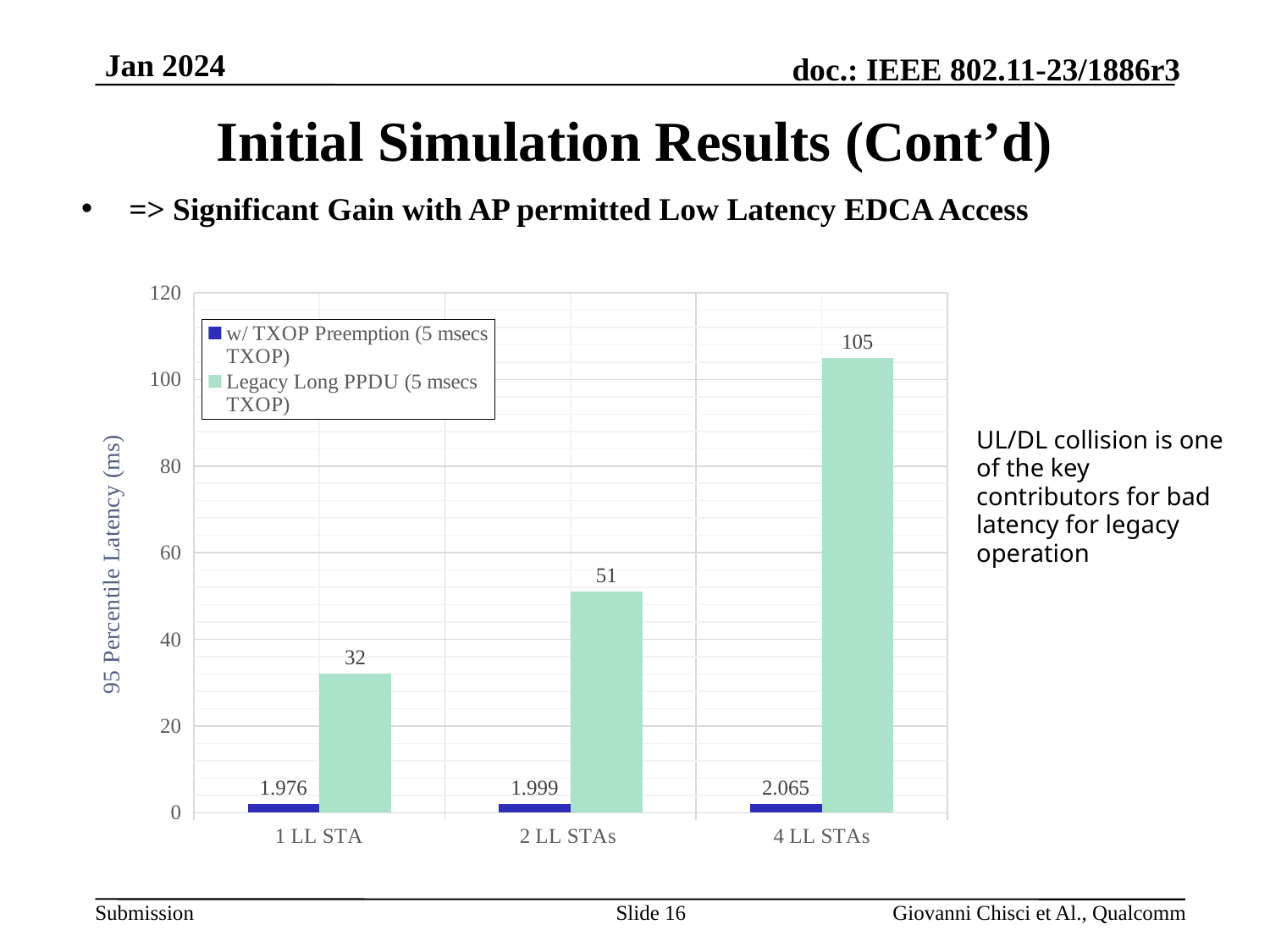
How many categories are shown on the x axis? 3 What is the difference between the Legacy Long PPDU values for 4 LL STAs and 2 LL STAs? 54 What is the value for Legacy Long PPDU (5 msecs TXOP) with 2 LL STAs? 51 Which category has the lowest w/ TXOP Preemption (5 msecs TXOP) latency? 1 LL STA What is the 95 percentile latency for w/ TXOP Preemption (5 msecs TXOP) with 1 LL STA? 1.976 Which is larger for 1 LL STA: the w/ TXOP Preemption value or the Legacy Long PPDU value? Legacy Long PPDU (5 msecs TXOP) Is the Legacy Long PPDU value for 4 LL STAs greater or less than 100? greater How many series does the legend list? 2 What kind of chart is shown on the slide? bar chart Which category has the highest Legacy Long PPDU (5 msecs TXOP) latency? 4 LL STAs Do the Legacy Long PPDU (5 msecs TXOP) values rise or fall from 1 LL STA to 4 LL STAs? rise What is the 95 percentile latency for Legacy Long PPDU (5 msecs TXOP) with 4 LL STAs? 105